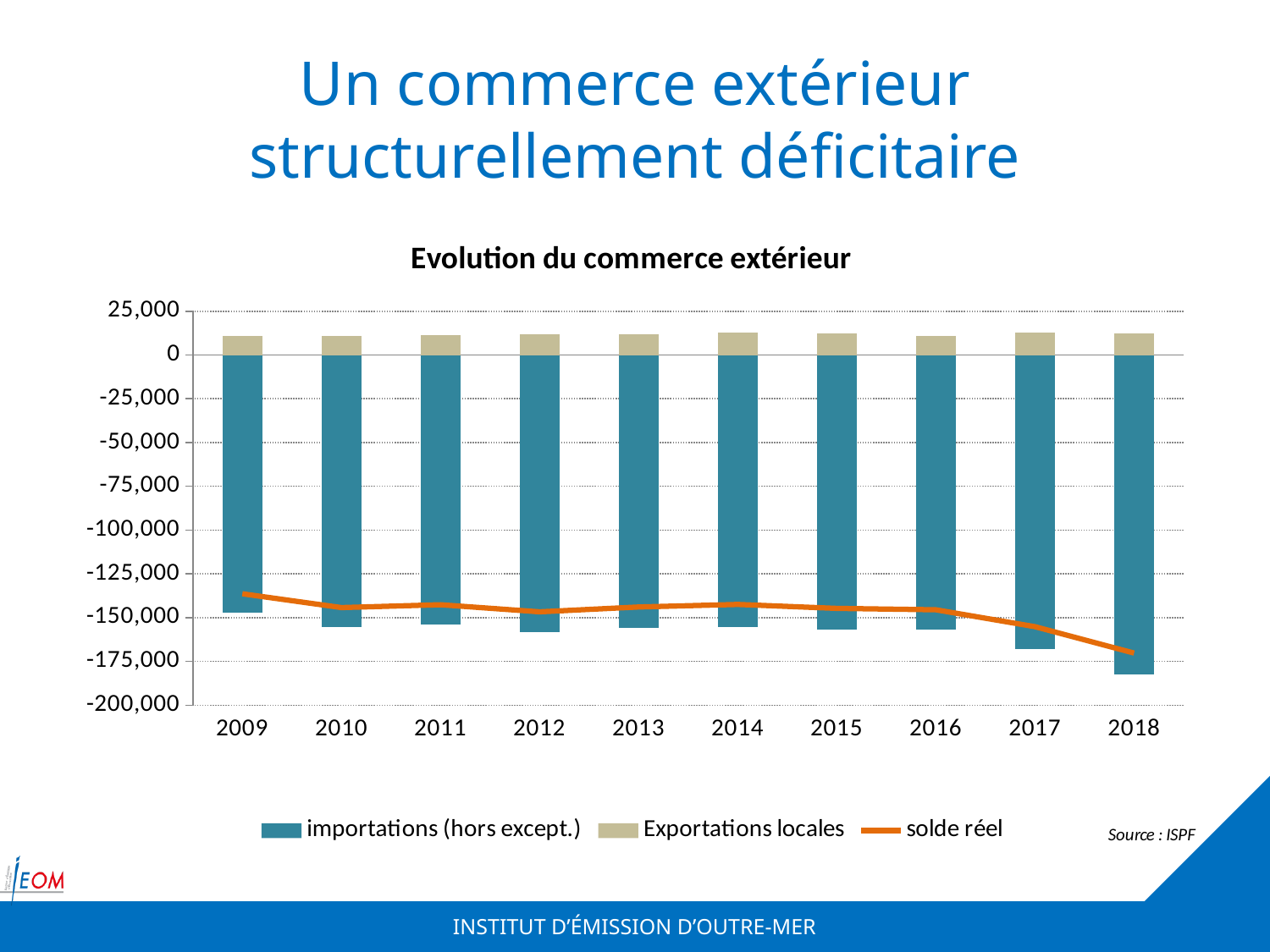
In which year is the solde réel line at its lowest point? 2018 What is the title of the chart? Evolution du commerce extérieur Is the importations (hors except.) value for 2017 greater or less than -150,000? less How many series does the legend list? 3 Is the importations (hors except.) value for 2018 greater or less than -175,000? less In which year is the solde réel line at its highest point? 2009 In which year is the importations (hors except.) bar the longest (most negative)? 2018 What kind of chart is shown on the slide? Bar chart with a line Does the solde réel line rise or fall between 2016 and 2018? fall Is the solde réel value for 2009 greater or less than -150,000? greater Which series is drawn as an orange line? solde réel How many years are shown on the x axis? 10